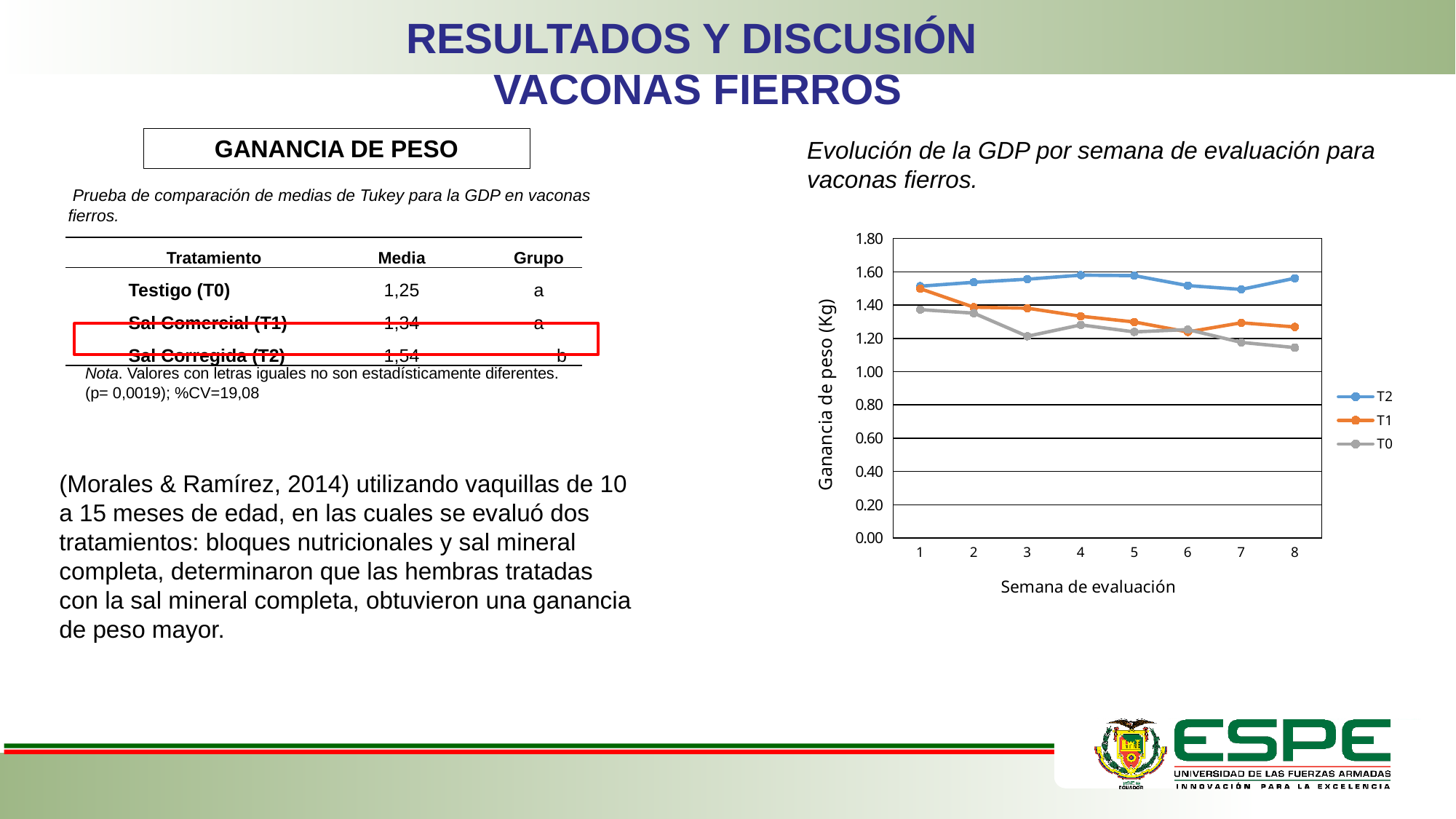
What kind of chart is shown on the slide? line chart Is the value for T0 in week 8 greater or less than 1.20? less Which series has the lowest value in week 8? T0 Is the value for T2 in week 4 greater or less than 1.40? greater How many evaluation weeks are plotted along the x axis of the chart? 8 How many series does the chart legend list? 3 In week 8, which series has the larger value, T2 or T0? T2 Does the T0 series rise or fall overall from week 1 to week 8? fall Which series has the highest value in week 8? T2 What is the label of the chart's y axis? Ganancia de peso (Kg) Is the value for T1 in week 1 greater or less than 1.40? greater